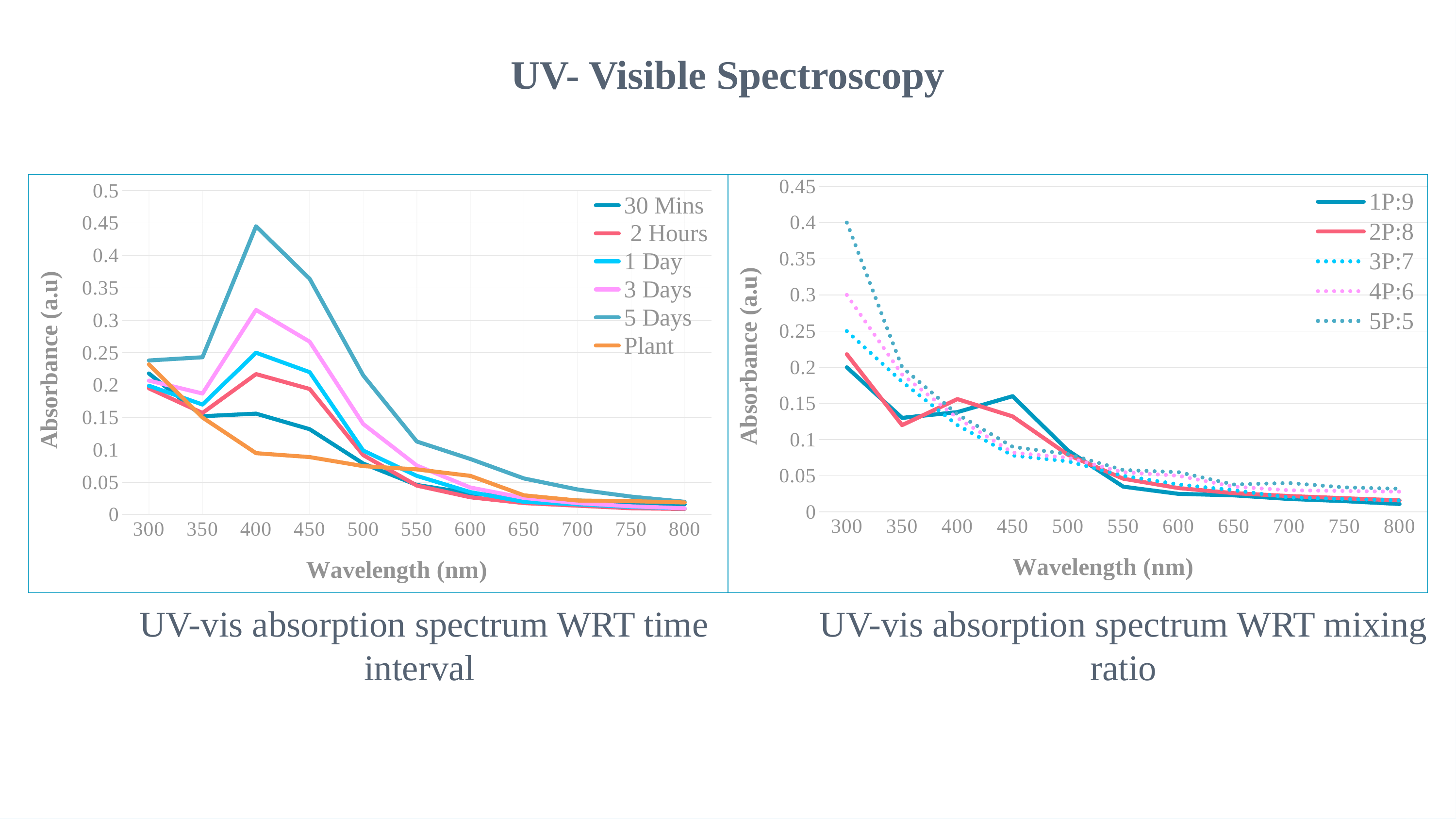
In the left chart (WRT time interval), which series has the lowest absorbance at 400 nm? Plant In the right chart (WRT mixing ratio), does the absorbance of 5P:5 rise or fall as wavelength increases from 300 nm to 800 nm? fall In the right chart (WRT mixing ratio), which series has the highest absorbance at 300 nm? 5P:5 In the left chart (WRT time interval), which is larger at 400 nm: 3 Days or 1 Day? 3 Days How many series does the legend of the left chart (WRT time interval) list? 6 In the left chart (WRT time interval), how many wavelength ticks are shown on the x axis? 11 What kind of chart is the left chart, 'UV-vis absorption spectrum WRT time interval'? Line chart In the left chart (WRT time interval), which series has the highest absorbance at 400 nm? 5 Days How many series does the legend of the right chart (WRT mixing ratio) list? 5 What is the label of the y axis on the right chart (WRT mixing ratio)? Absorbance (a.u) In the left chart (WRT time interval), is the absorbance of 5 Days at 400 nm greater or less than 0.4? greater